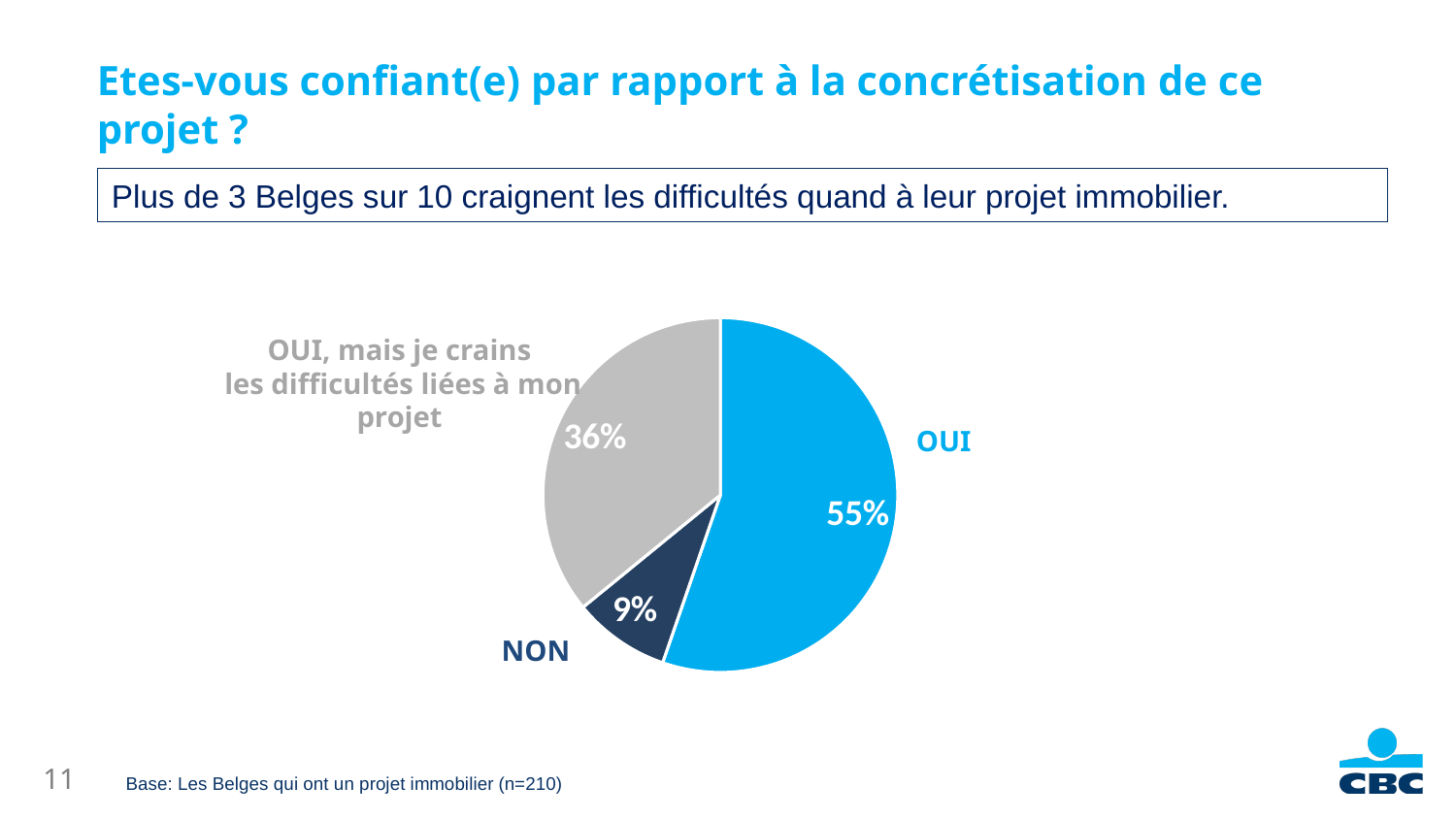
Which response has the largest share of the pie? OUI What is the difference in percentage points between "OUI" and "OUI, mais je crains les difficultés liées à mon projet"? 19 What percentage of respondents answered "OUI"? 55% How many slices does the pie chart have? 3 Which response has the smallest share of the pie? NON What kind of chart is shown on the slide? Pie chart What is the combined share of "OUI" and "OUI, mais je crains les difficultés liées à mon projet"? 91% What percentage of respondents answered "OUI, mais je crains les difficultés liées à mon projet"? 36% Which is larger: the share for "NON" or the share for "OUI, mais je crains les difficultés liées à mon projet"? OUI, mais je crains les difficultés liées à mon projet What is the difference in percentage points between "OUI, mais je crains les difficultés liées à mon projet" and "NON"? 27 What percentage of respondents answered "NON"? 9% What colour is the "NON" slice of the pie chart? Dark navy blue